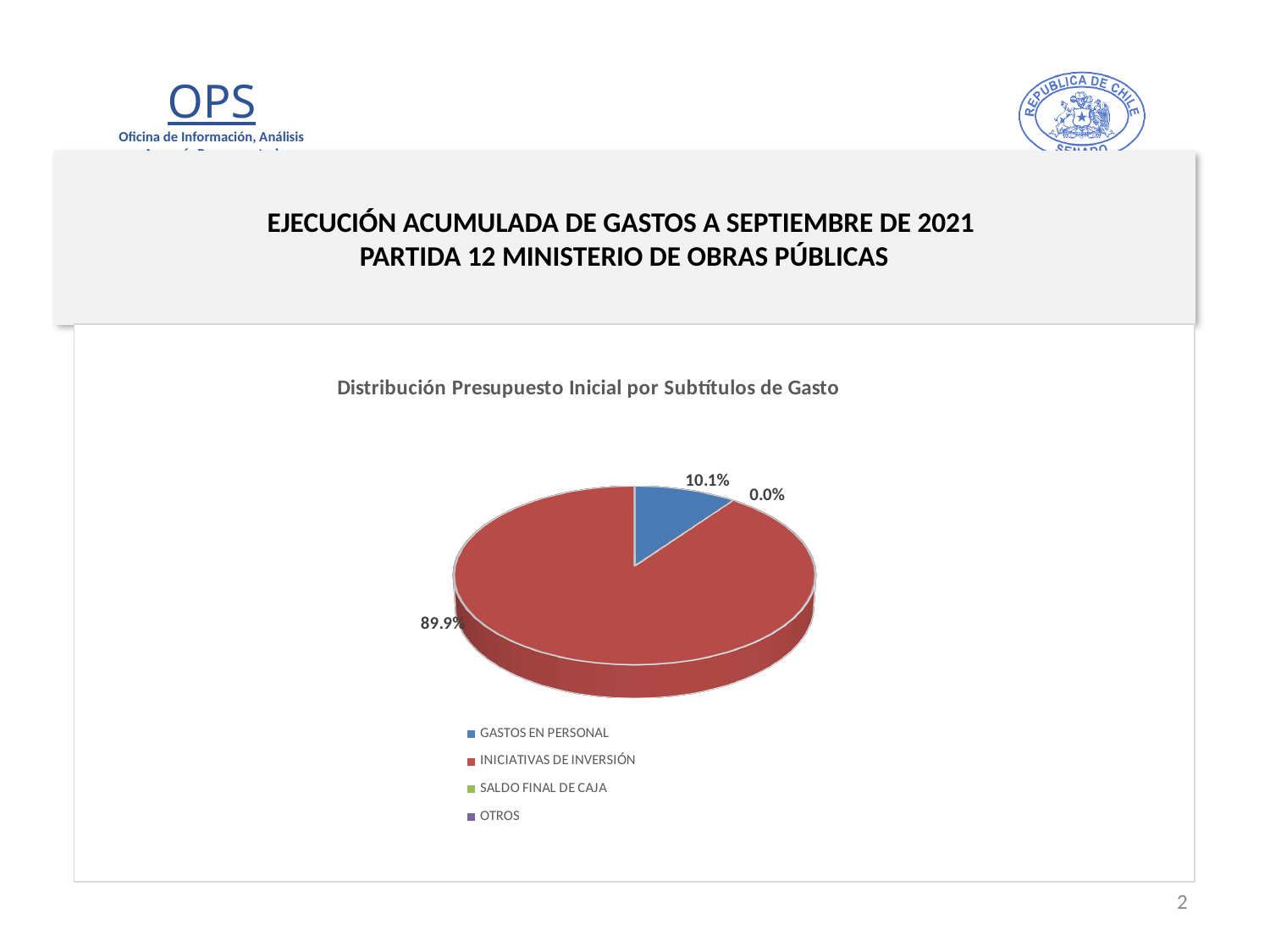
How many categories does the legend of the pie chart list? 4 By how many percentage points does the INICIATIVAS DE INVERSIÓN share exceed the GASTOS EN PERSONAL share? 79.8 percentage points Which category has the largest slice of the pie? INICIATIVAS DE INVERSIÓN What is the title of the chart? Distribución Presupuesto Inicial por Subtítulos de Gasto What colour is the slice for INICIATIVAS DE INVERSIÓN? Red Which is larger, the slice for GASTOS EN PERSONAL or the slice for INICIATIVAS DE INVERSIÓN? INICIATIVAS DE INVERSIÓN What kind of chart is shown on the slide? Pie chart What share of the pie does INICIATIVAS DE INVERSIÓN represent? 89.9% What share of the pie does GASTOS EN PERSONAL represent? 10.1% Is the share for GASTOS EN PERSONAL greater or less than 50%? less What is the combined share of GASTOS EN PERSONAL and INICIATIVAS DE INVERSIÓN? 100.0%